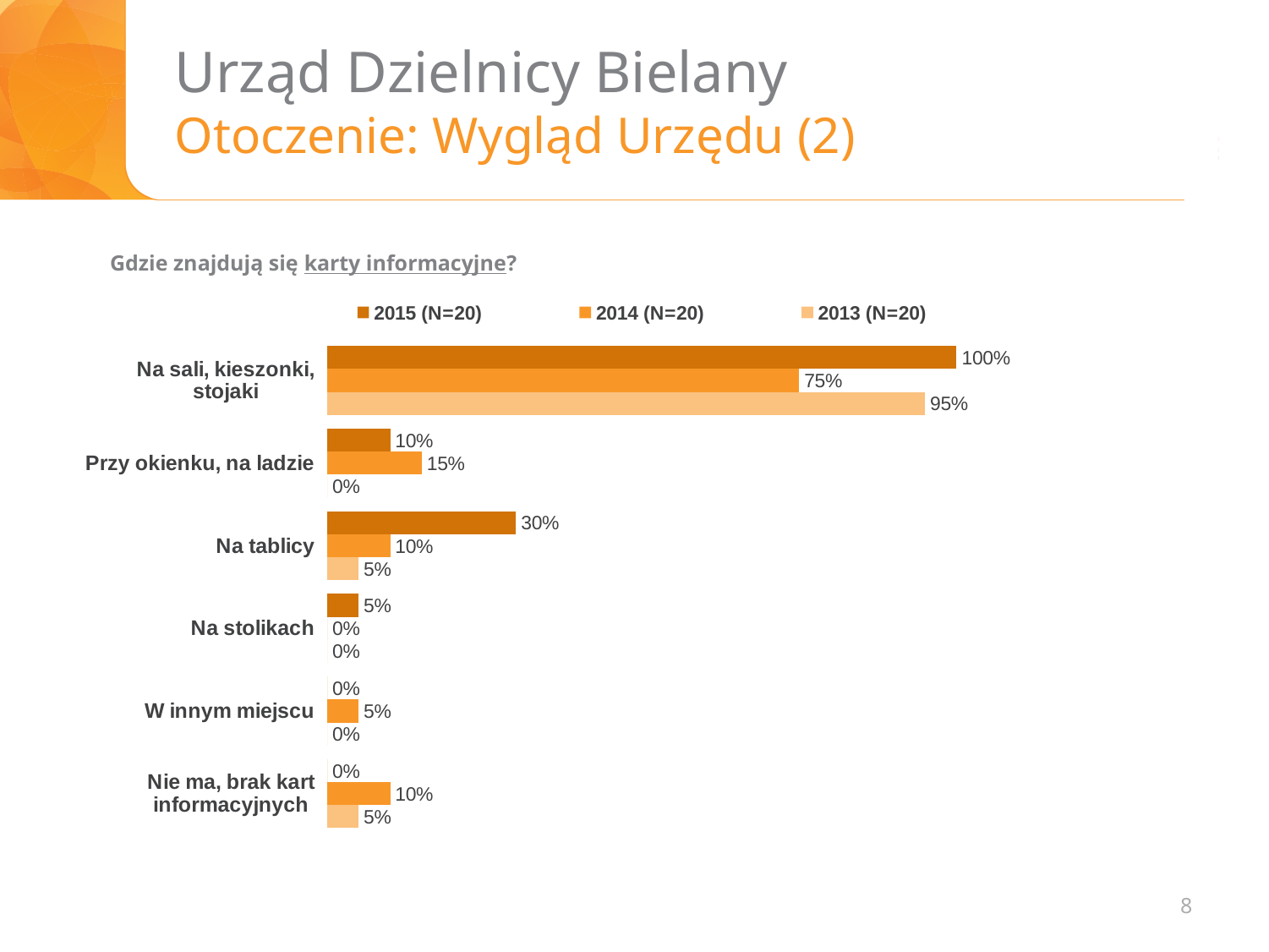
What kind of chart is shown on the slide? Bar chart What is the value for 'Przy okienku, na ladzie' in the 2014 (N=20) series? 15% What is the value for 'Na tablicy' in the 2013 (N=20) series? 5% How many series does the legend list? 3 How many categories are shown on the chart? 6 What question is the chart answering, as stated above it? Gdzie znajdują się karty informacyjne? Which category has the highest value in the 2015 (N=20) series? Na sali, kieszonki, stojaki What is the difference between the 2015 (N=20) and 2014 (N=20) values for 'Na sali, kieszonki, stojaki'? 25% Which is larger for 'Na tablicy': the 2015 (N=20) value or the 2014 (N=20) value? 2015 (N=20) What is the value for 'Na sali, kieszonki, stojaki' in the 2015 (N=20) series? 100% What is the value for 'Nie ma, brak kart informacyjnych' in the 2014 (N=20) series? 10% What is the difference between the 2015 (N=20) and 2013 (N=20) values for 'Na tablicy'? 25%